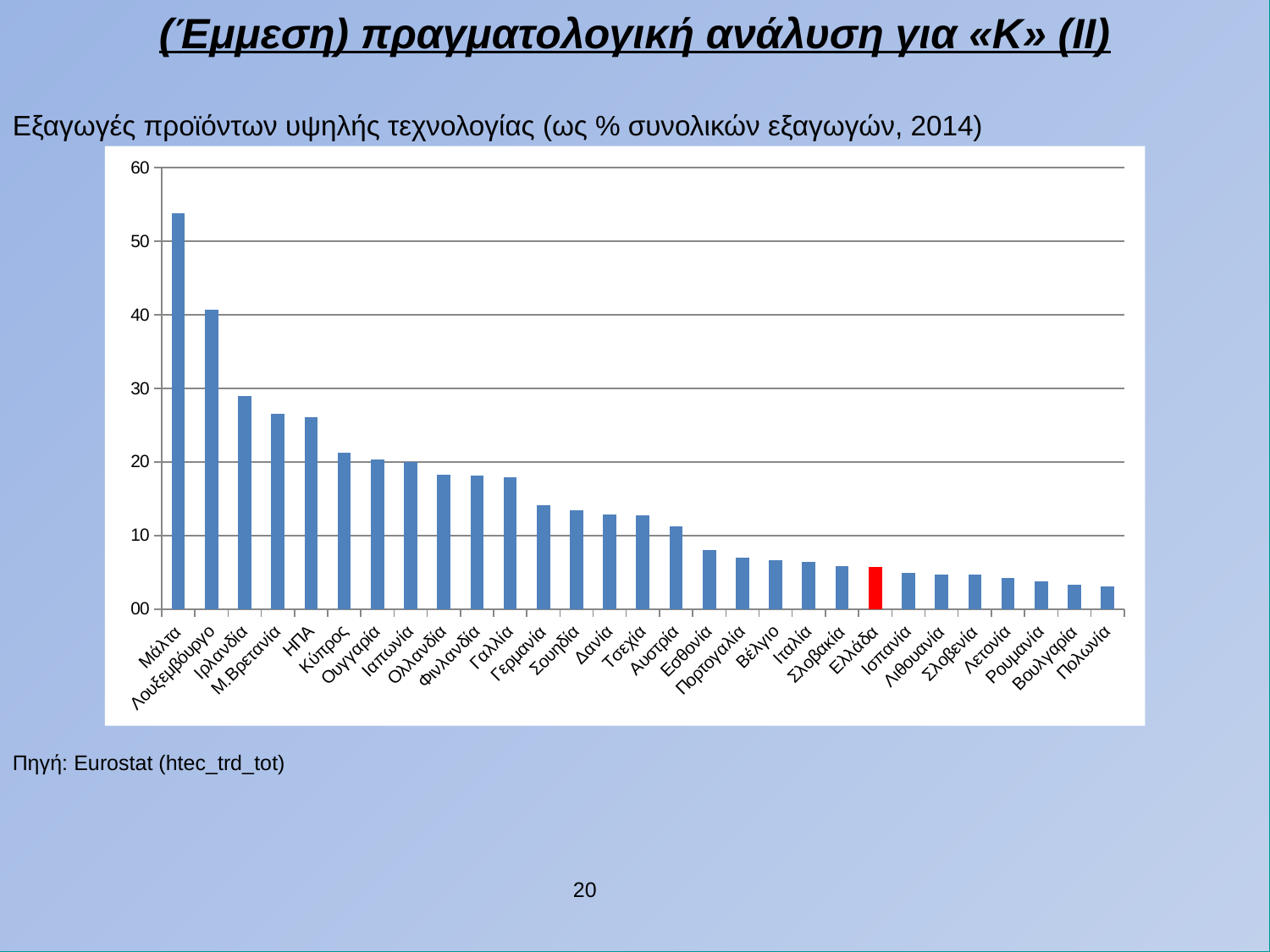
Which country has the highest share of high-technology exports in the chart? Μάλτα Do the bar values rise or fall moving from left to right along the x axis? Fall Which country's bar is coloured red in the chart? Ελλάδα Is the value for Λουξεμβούργο greater or less than 40? greater Is the value for ΗΠΑ greater or less than 20? greater What kind of chart is shown on the slide? Bar chart Is the value for Ιρλανδία greater or less than 30? less How many countries are shown on the x axis of the chart? 29 Which has a higher value, Ιαπωνία or Γερμανία? Ιαπωνία Which has a higher value, Κύπρος or Ελλάδα? Κύπρος